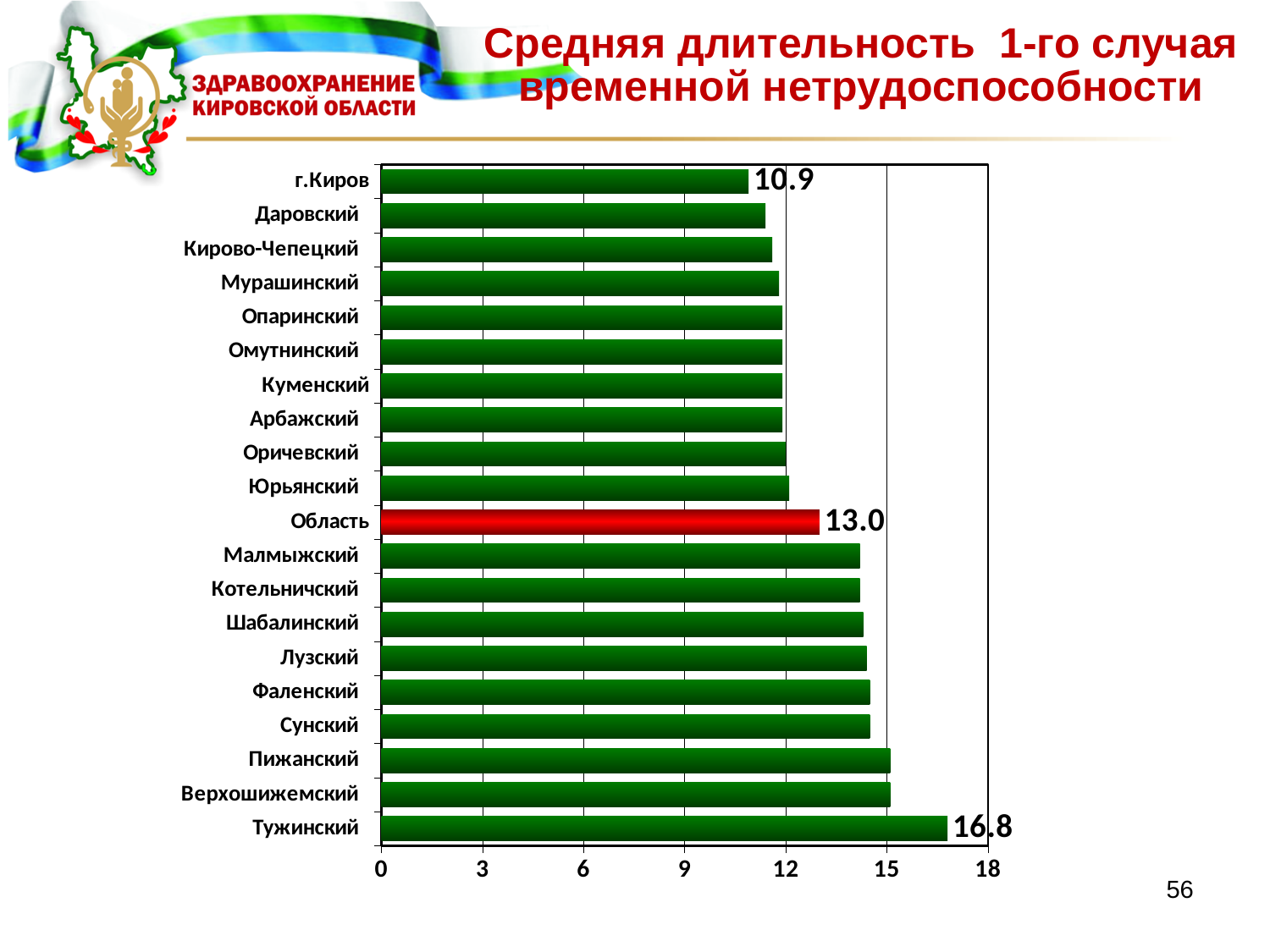
Is the value for Даровский greater or less than 12? less Which is larger, the value for Область or the value for г.Киров? Область Which category has the highest value? Тужинский What is the difference between the values for Тужинский and г.Киров? 5.9 Which category has the lowest value? г.Киров What is the value for г.Киров? 10.9 What is the value for Область? 13.0 Is the value for Малмыжский greater or less than 12? greater What is the difference between the values for Область and г.Киров? 2.1 How many categories are shown in the chart? 20 What is the value for Тужинский? 16.8 What kind of chart is shown on the slide? bar chart